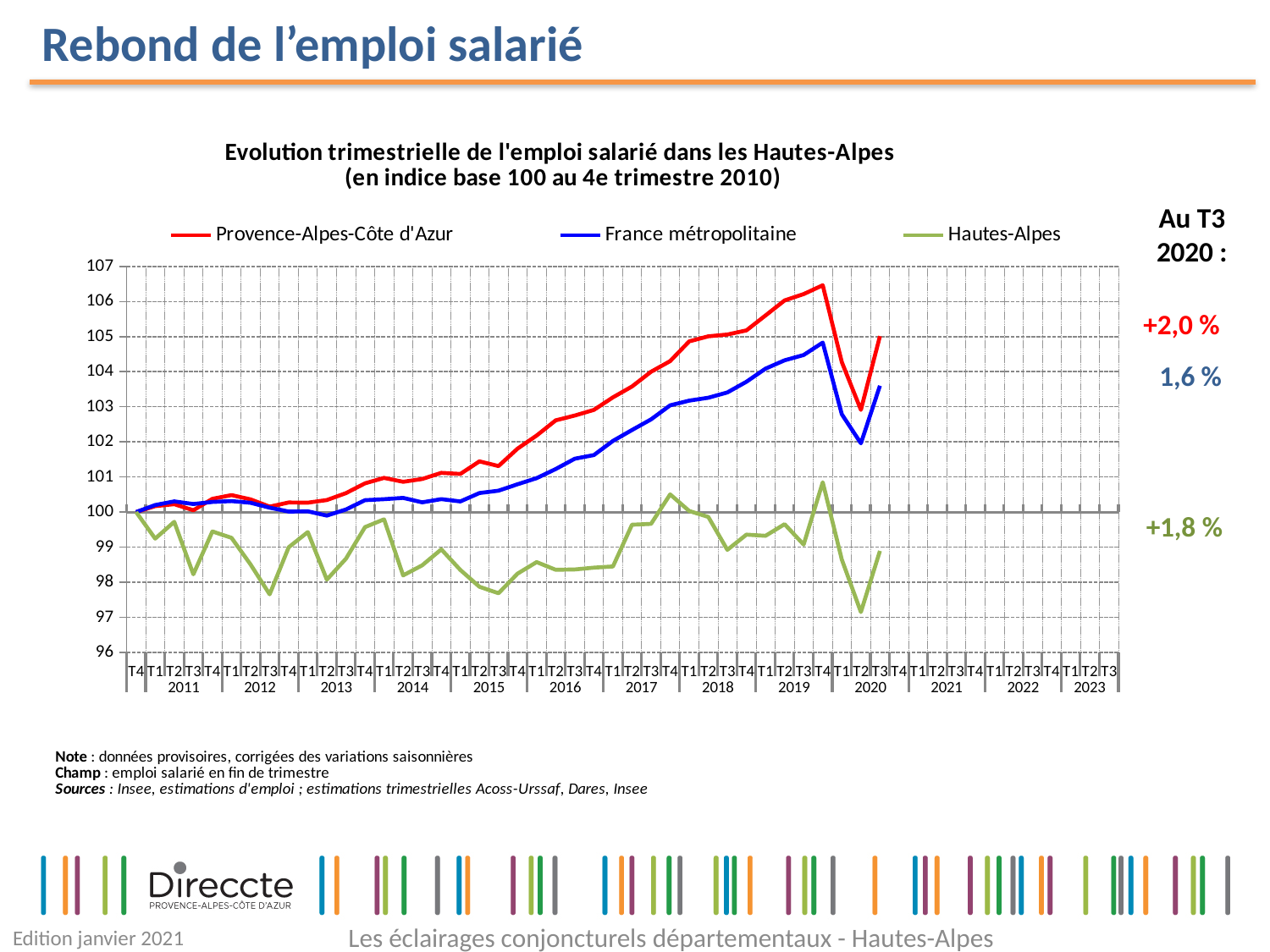
Is the value for Hautes-Alpes at T2 2020 greater or less than 98? less Which series has the lowest value at T2 2020? Hautes-Alpes How many series does the legend list? 3 Which series is drawn in green in the legend? Hautes-Alpes What change is annotated for France métropolitaine at T3 2020? 1,6 % What kind of chart is shown on the slide? line chart What is the title of the chart? Evolution trimestrielle de l'emploi salarié dans les Hautes-Alpes (en indice base 100 au 4e trimestre 2010) Is the value for Provence-Alpes-Côte d'Azur at T4 2019 greater or less than 106? greater What change is annotated for Provence-Alpes-Côte d'Azur at T3 2020? +2,0 % At T4 2019, which is larger: the value for Provence-Alpes-Côte d'Azur or for France métropolitaine? Provence-Alpes-Côte d'Azur What change is annotated for Hautes-Alpes at T3 2020? +1,8 % Which series has the highest value at T4 2019? Provence-Alpes-Côte d'Azur